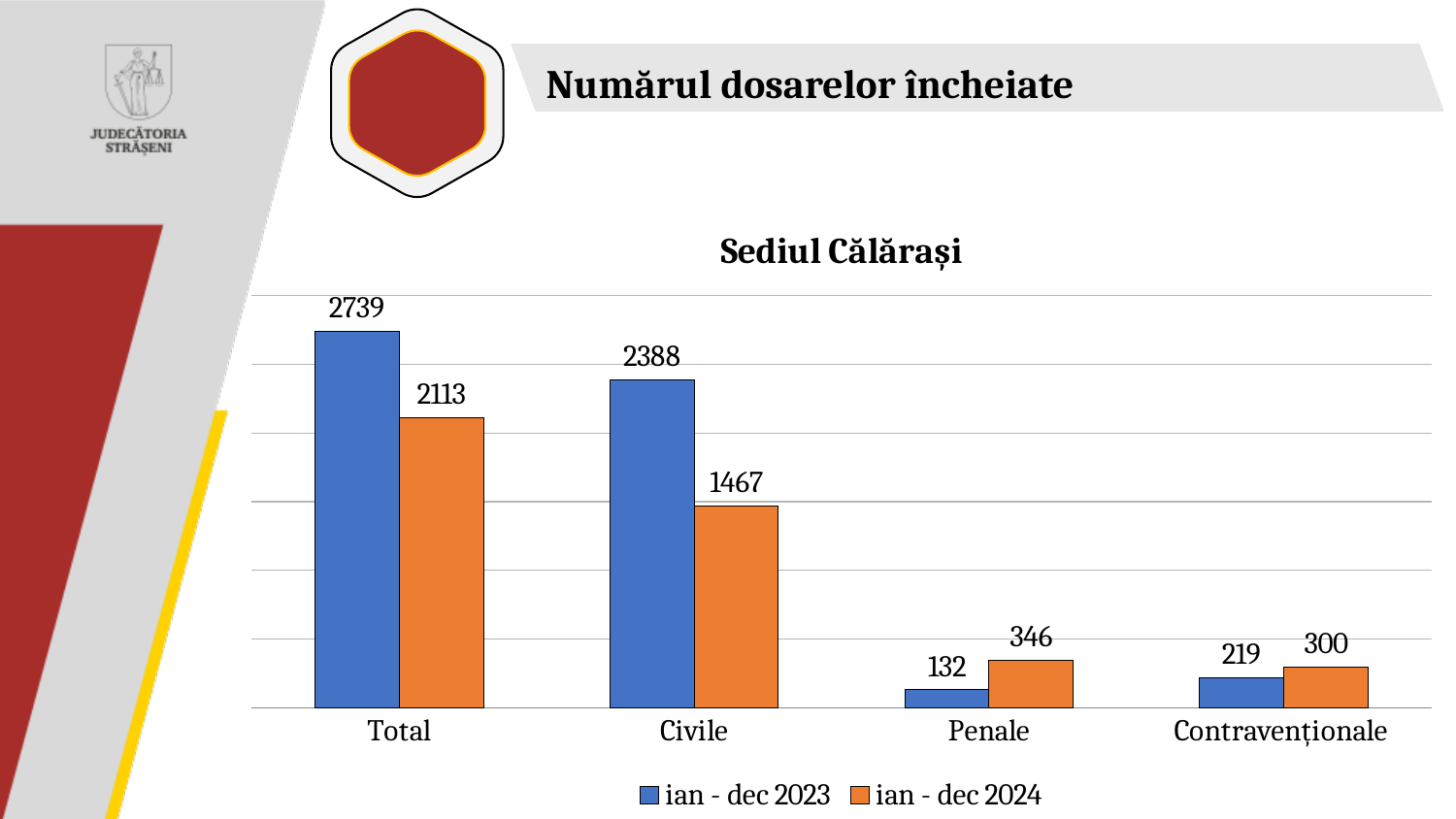
How many categories are shown on the x axis? 4 Which category has the lowest value in the ian - dec 2023 series? Penale How many series does the legend list? 2 Which category has the highest value in the ian - dec 2024 series? Total What is the value for Penale in the ian - dec 2023 series? 132 What is the value for Total in the ian - dec 2023 series? 2739 What is the difference between the ian - dec 2024 and ian - dec 2023 values for Penale? 214 What is the value for Contravenționale in the ian - dec 2024 series? 300 What is the value for Civile in the ian - dec 2024 series? 1467 What is the difference between the ian - dec 2023 and ian - dec 2024 values for Total? 626 What kind of chart is shown on the slide? Bar chart Which is larger for Contravenționale: the ian - dec 2023 value or the ian - dec 2024 value? ian - dec 2024